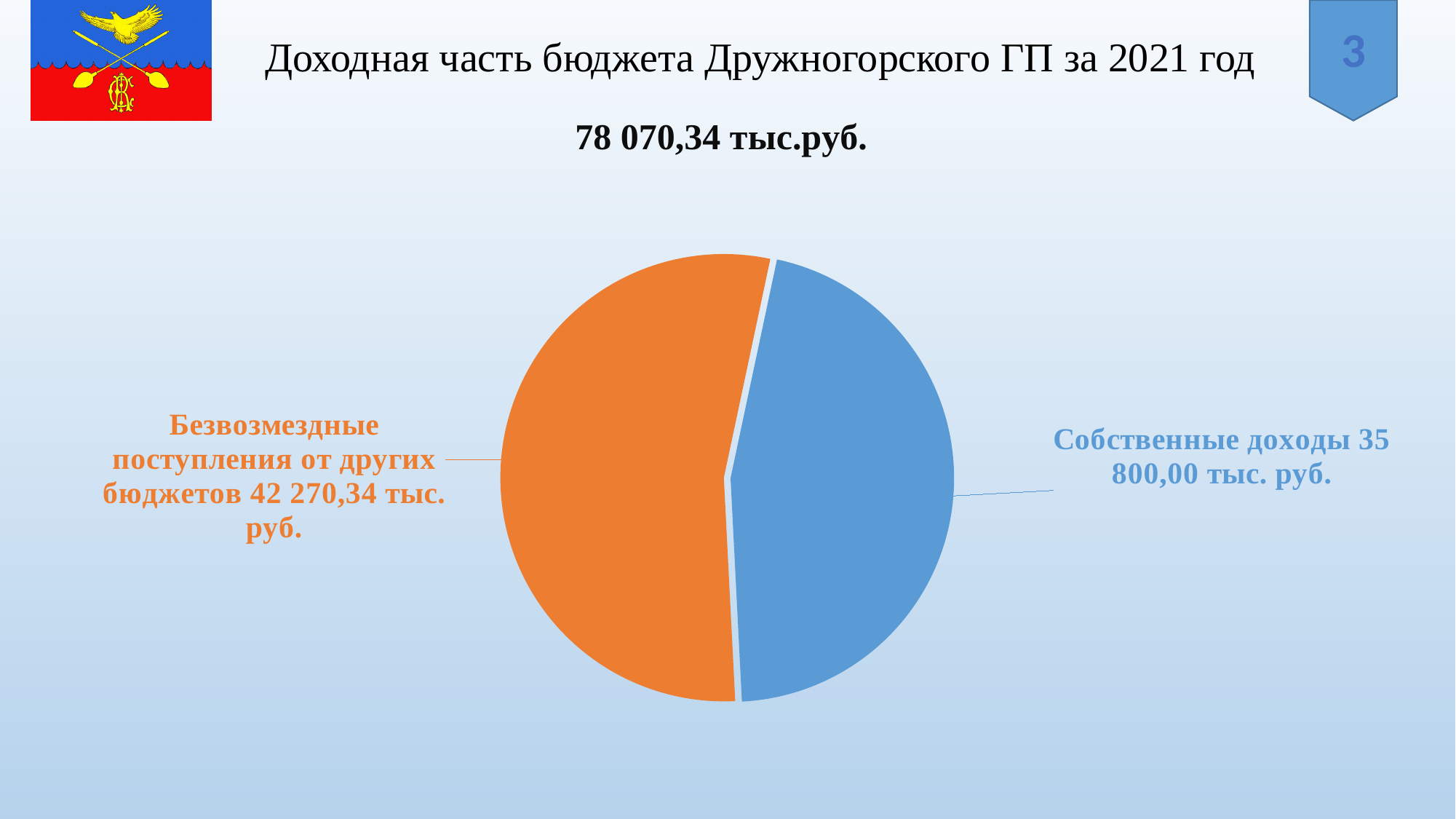
What is the title of the slide containing the chart? Доходная часть бюджета Дружногорского ГП за 2021 год Which category has the largest slice of the pie? Безвозмездные поступления от других бюджетов Which is larger: Собственные доходы or Безвозмездные поступления от других бюджетов? Безвозмездные поступления от других бюджетов To the nearest whole percent, what share of the total does Собственные доходы represent? 46% What is the value shown for Собственные доходы? 35 800,00 тыс. руб. What colour is the slice for Собственные доходы? Blue What kind of chart is shown on the slide? Pie chart What is the total of the budget revenue shown on the slide? 78 070,34 тыс.руб. How many slices does the pie chart have? 2 What is the value shown for Безвозмездные поступления от других бюджетов? 42 270,34 тыс. руб. What is the difference between Безвозмездные поступления от других бюджетов and Собственные доходы, in тыс. руб.? 6 470,34 тыс. руб. Which category has the smallest slice of the pie? Собственные доходы